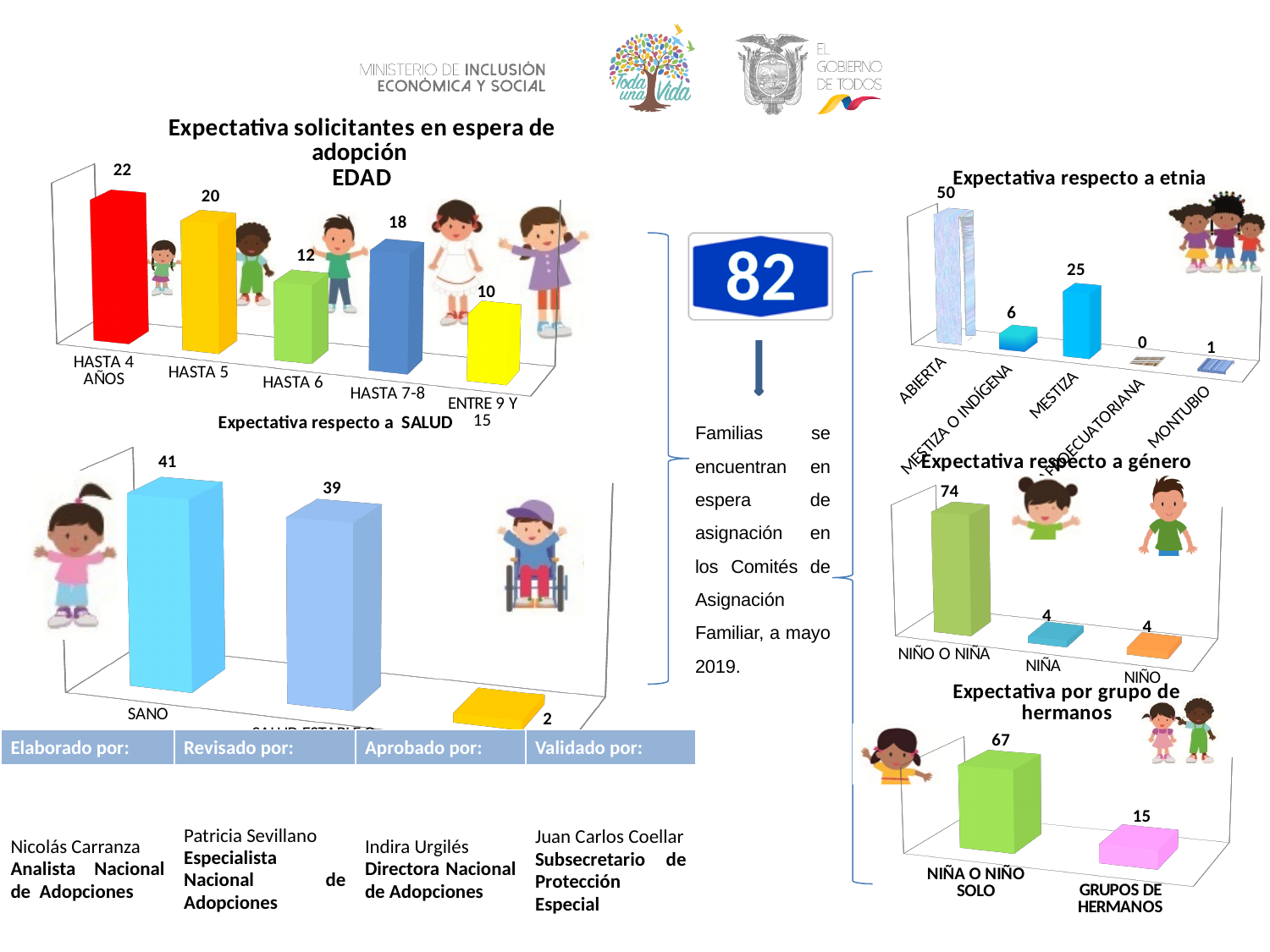
In the 'Expectativa respecto a etnia' chart, what is the value for AFROECUATORIANA? 0 In the 'Expectativa respecto a etnia' chart, which category has the highest value? ABIERTA In the 'Expectativa respecto a etnia' chart, what is the value for MESTIZA? 25 In the 'Expectativa respecto a SALUD' chart, what is the value for SANO? 41 What kind of chart is 'Expectativa por grupo de hermanos'? Bar chart In the 'Expectativa respecto a género' chart, what is the value for NIÑO O NIÑA? 74 In the 'Expectativa solicitantes en espera de adopción EDAD' chart, how many categories are shown? 5 In the 'Expectativa solicitantes en espera de adopción EDAD' chart, what is the value for HASTA 4 AÑOS? 22 In the 'Expectativa solicitantes en espera de adopción EDAD' chart, what is the difference between HASTA 5 and HASTA 6? 8 In the 'Expectativa solicitantes en espera de adopción EDAD' chart, which category has the lowest value? ENTRE 9 Y 15 In the 'Expectativa respecto a SALUD' chart, which is larger, SANO or SALUD ESTABLE? SANO In the 'Expectativa por grupo de hermanos' chart, what is the difference between NIÑA O NIÑO SOLO and GRUPOS DE HERMANOS? 52